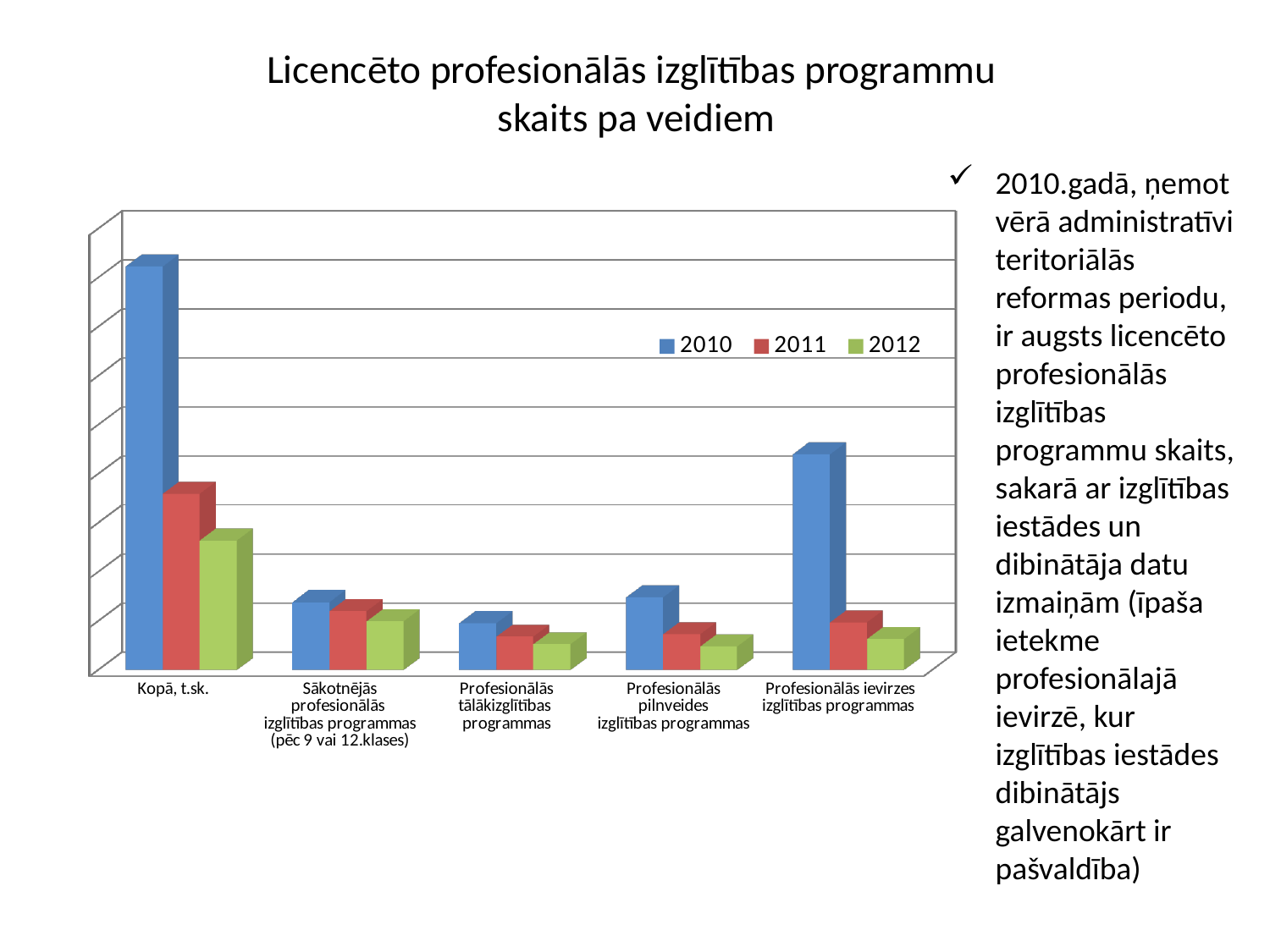
For 2010, which is larger: Profesionālās ievirzes izglītības programmas or Profesionālās pilnveides izglītības programmas? Profesionālās ievirzes izglītības programmas Which category has the highest value for 2012? Kopā, t.sk. What is the title of the chart? Licencēto profesionālās izglītības programmu skaits pa veidiem Within the Kopā, t.sk. category, do the values rise or fall from 2010 to 2012? fall Which colour represents the 2011 series in the legend? red Which category has the highest value for 2010? Kopā, t.sk. How many series does the legend list? 3 Which series has the highest value in every category? 2010 For Kopā, t.sk., which is larger: the 2010 value or the 2012 value? 2010 Which category has the lowest value for 2010? Profesionālās tālākizglītības programmas What kind of chart is shown on the slide? bar chart How many categories are shown on the x axis? 5